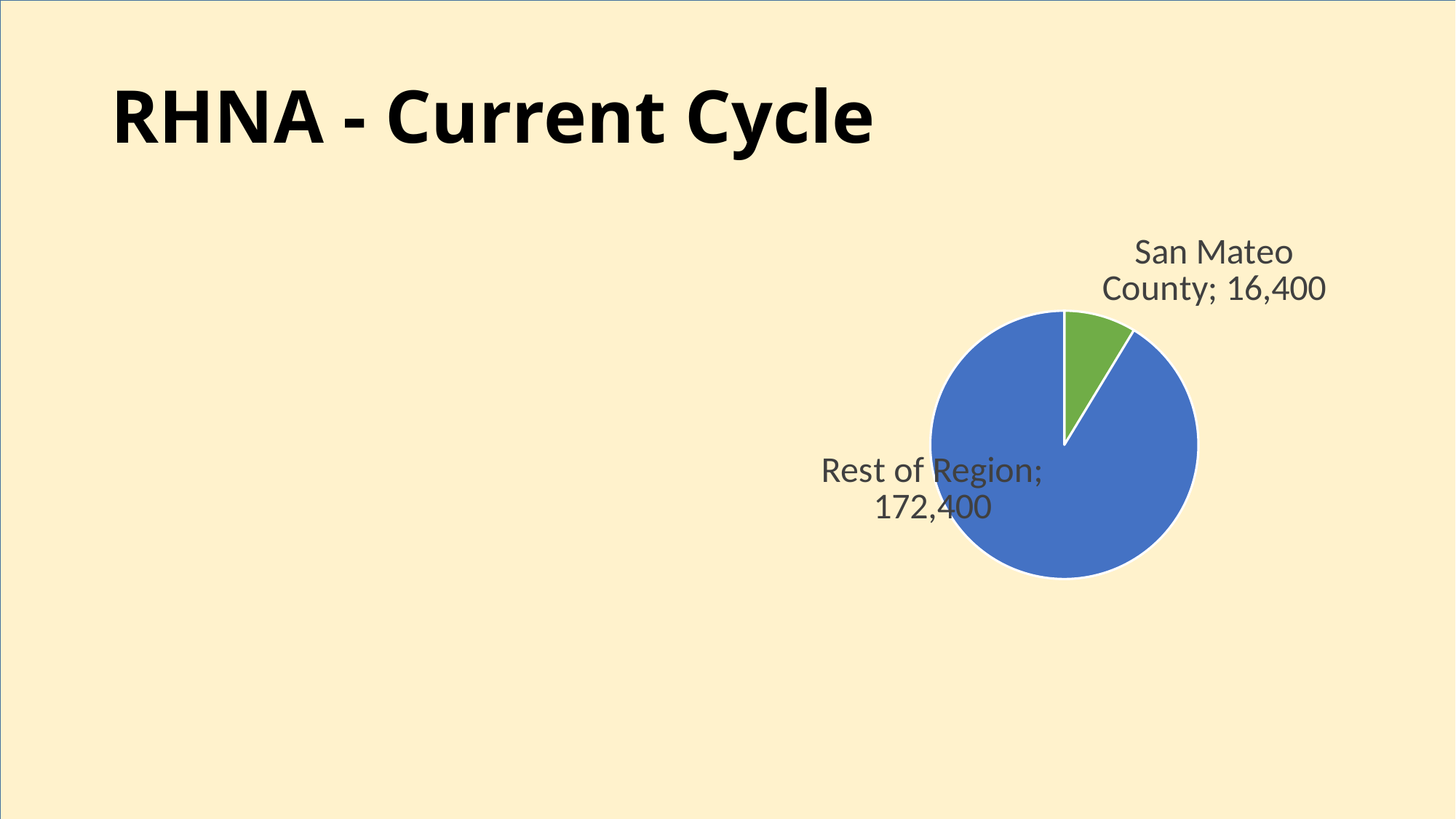
What is the total of the two values shown in the pie chart? 188,800 Which slice of the pie chart is the largest? Rest of Region What share of the pie does Rest of Region represent, to the nearest whole percent? 91% What is the difference between the Rest of Region value and the San Mateo County value? 156,000 What share of the pie does San Mateo County represent, to the nearest whole percent? 9% Which slice of the pie chart is the smallest? San Mateo County How many slices does the pie chart have? 2 What value is shown for Rest of Region in the pie chart? 172,400 What colour is the San Mateo County slice in the pie chart? Green What kind of chart is shown on the slide? Pie chart What value is shown for San Mateo County in the pie chart? 16,400 Which is larger, the value for San Mateo County or the value for Rest of Region? Rest of Region